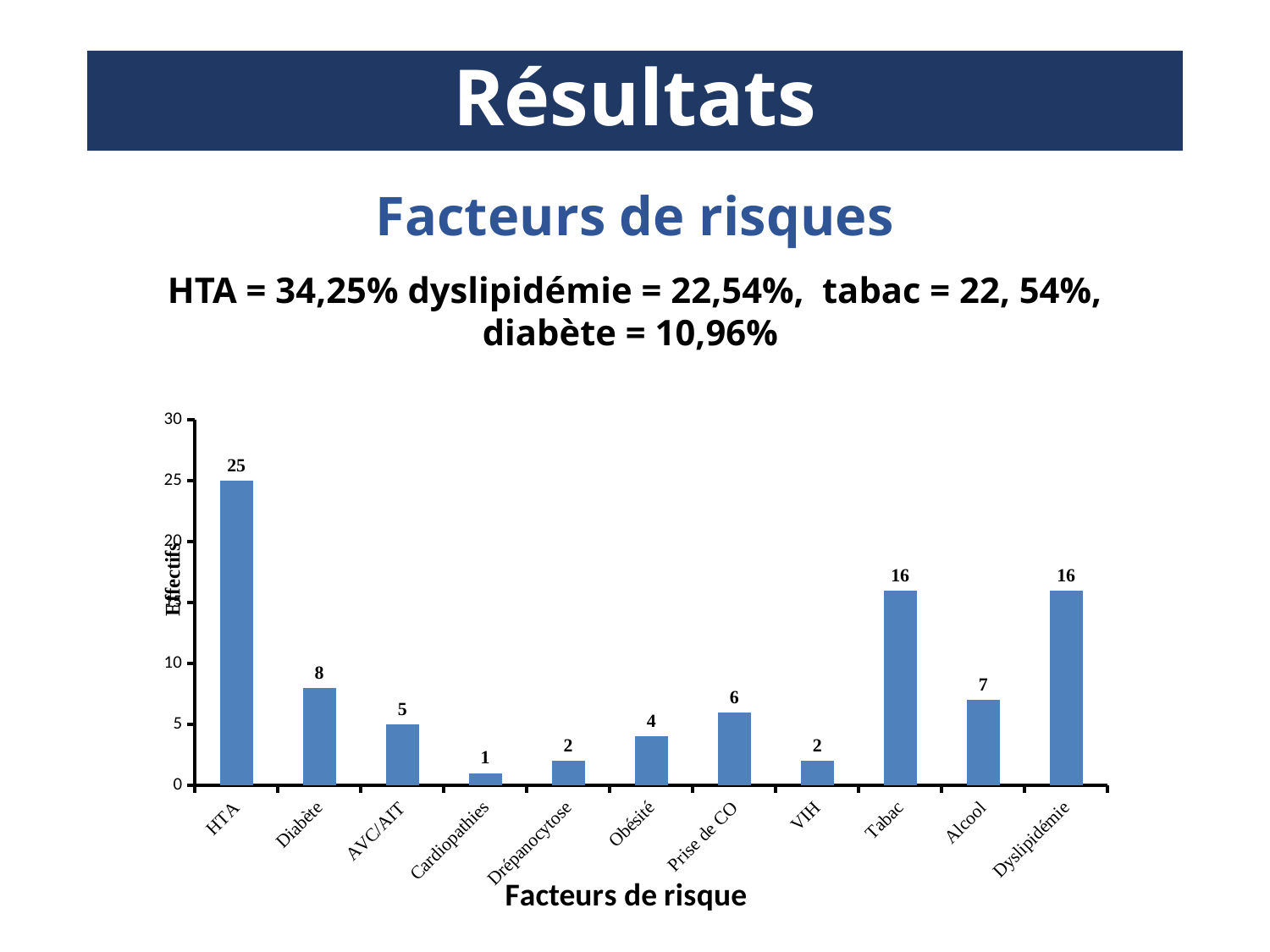
What kind of chart is shown? bar chart Which risk factor has the highest value? HTA What is the value for Prise de CO? 6 What is the difference between the values for Alcool and Obésité? 3 Which is larger, the value for AVC/AIT or the value for Alcool? Alcool What is the difference between the values for HTA and Tabac? 9 Which risk factor has the lowest value? Cardiopathies What is the value for HTA? 25 What is the label of the x axis? Facteurs de risque How many risk factor categories are shown on the x axis? 11 What is the value for Diabète? 8 What is the label of the y axis? Effectifs